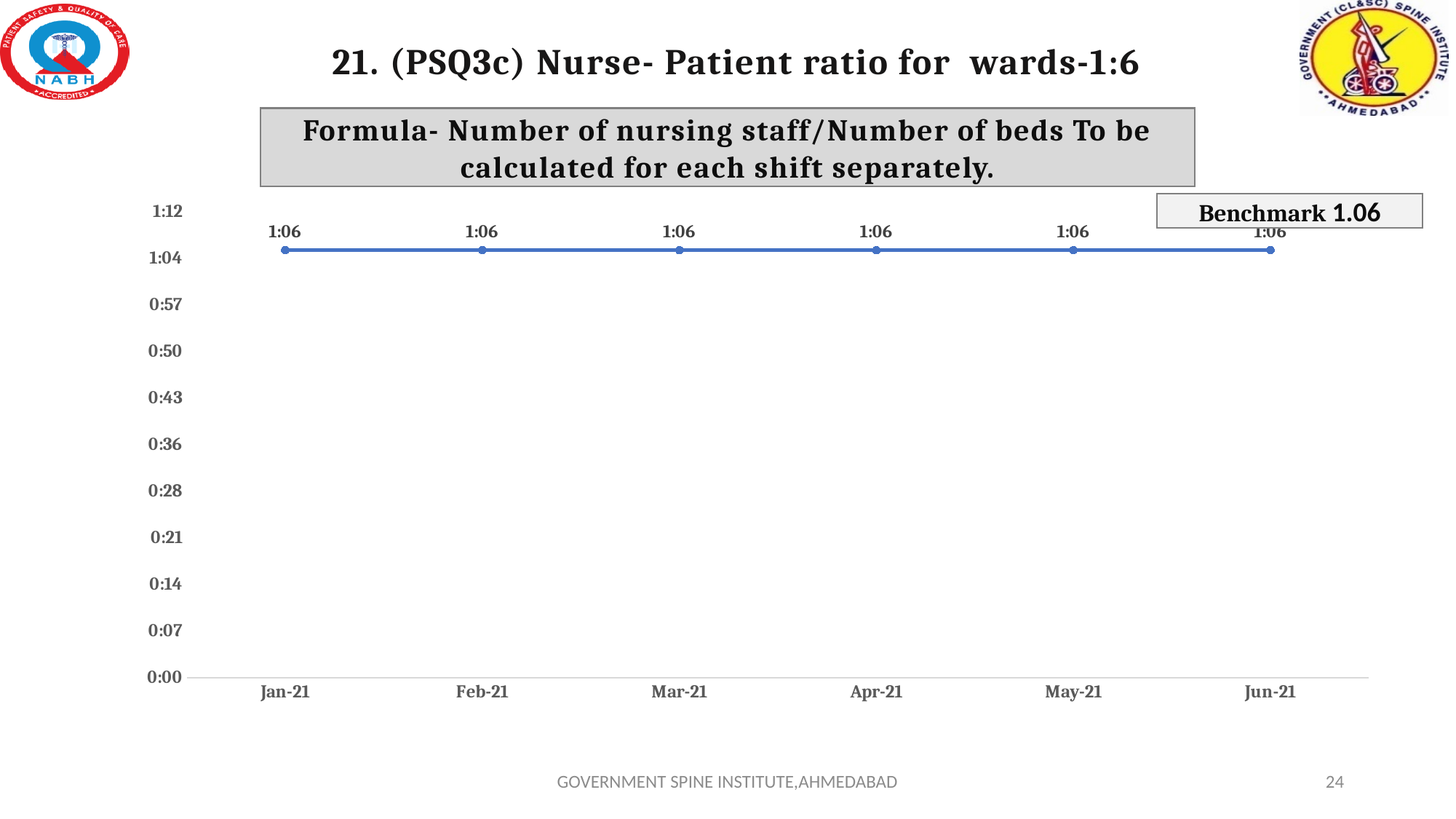
What kind of chart is shown on the slide? line chart What is the first month shown on the x axis? Jan-21 What is the difference between the values for Mar-21 and May-21? 0 What is the value plotted for Jun-21? 1:06 Do the plotted values rise, fall or stay flat from Jan-21 to Jun-21? stay flat Is the value for May-21 greater or less than 1:12? less What benchmark value is stated on the slide? 1.06 Is the value for Feb-21 greater or less than 0:57? greater What is the value plotted for Jan-21? 1:06 How many months are plotted on the x axis? 6 What is the value plotted for Apr-21? 1:06